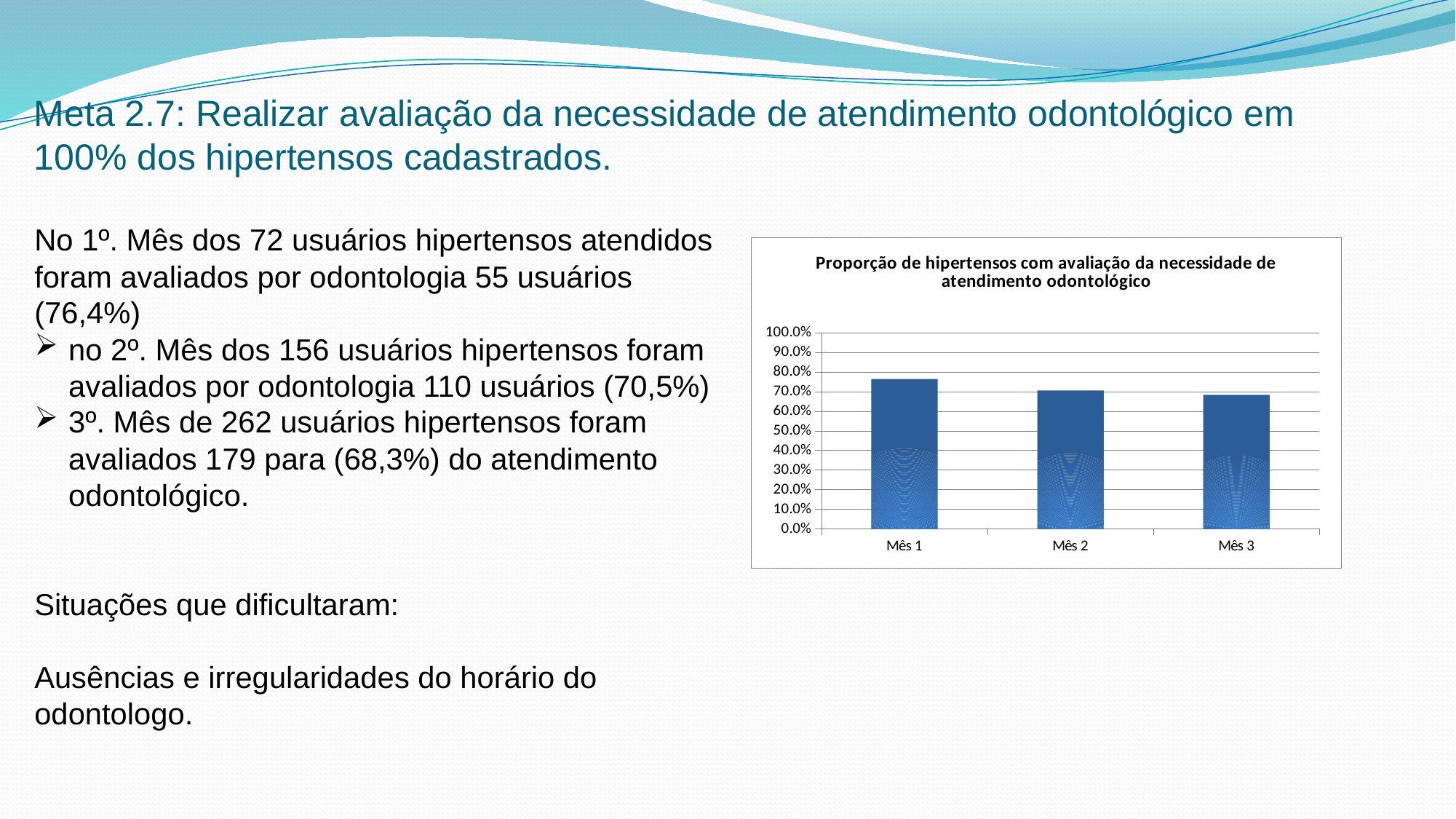
Is the value for Mês 3 greater or less than 60.0%? greater What kind of chart is shown on the slide? bar chart Do the values rise or fall from Mês 1 to Mês 3? fall What is the title of the chart? Proporção de hipertensos com avaliação da necessidade de atendimento odontológico Which month has the lowest bar in the chart? Mês 3 What is the maximum value shown on the y axis of the chart? 100.0% Which month has the highest bar in the chart? Mês 1 How many categories are plotted on the x axis of the chart? 3 Is the value for Mês 1 greater or less than 70.0%? greater Is the value for Mês 2 greater or less than 80.0%? less Which is larger, the value for Mês 1 or the value for Mês 3? Mês 1